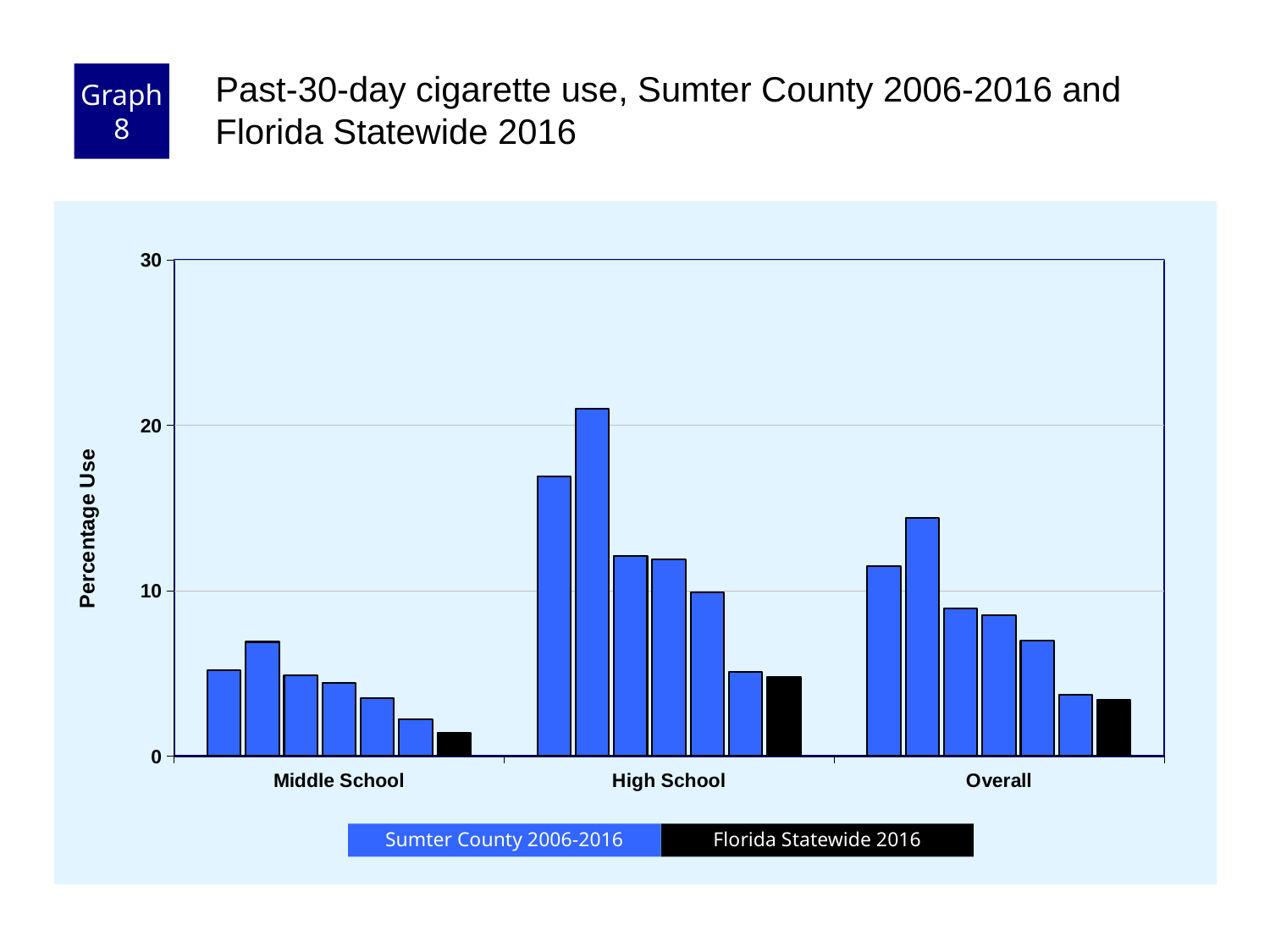
Which colour represents Florida Statewide 2016 in the legend? black Is the tallest Sumter County bar for Overall greater or less than 10? greater How many categories are shown on the x axis? 3 Which is larger, the Florida Statewide 2016 value for High School or for Middle School? High School What is the label on the y axis? Percentage Use Is the Florida Statewide 2016 value for High School greater or less than 10? less What kind of chart is shown on the slide? bar chart Is the tallest Sumter County bar for Middle School greater or less than 10? less Which category has the lowest bars overall? Middle School How many series does the legend list? 2 Which category has the tallest bar overall? High School